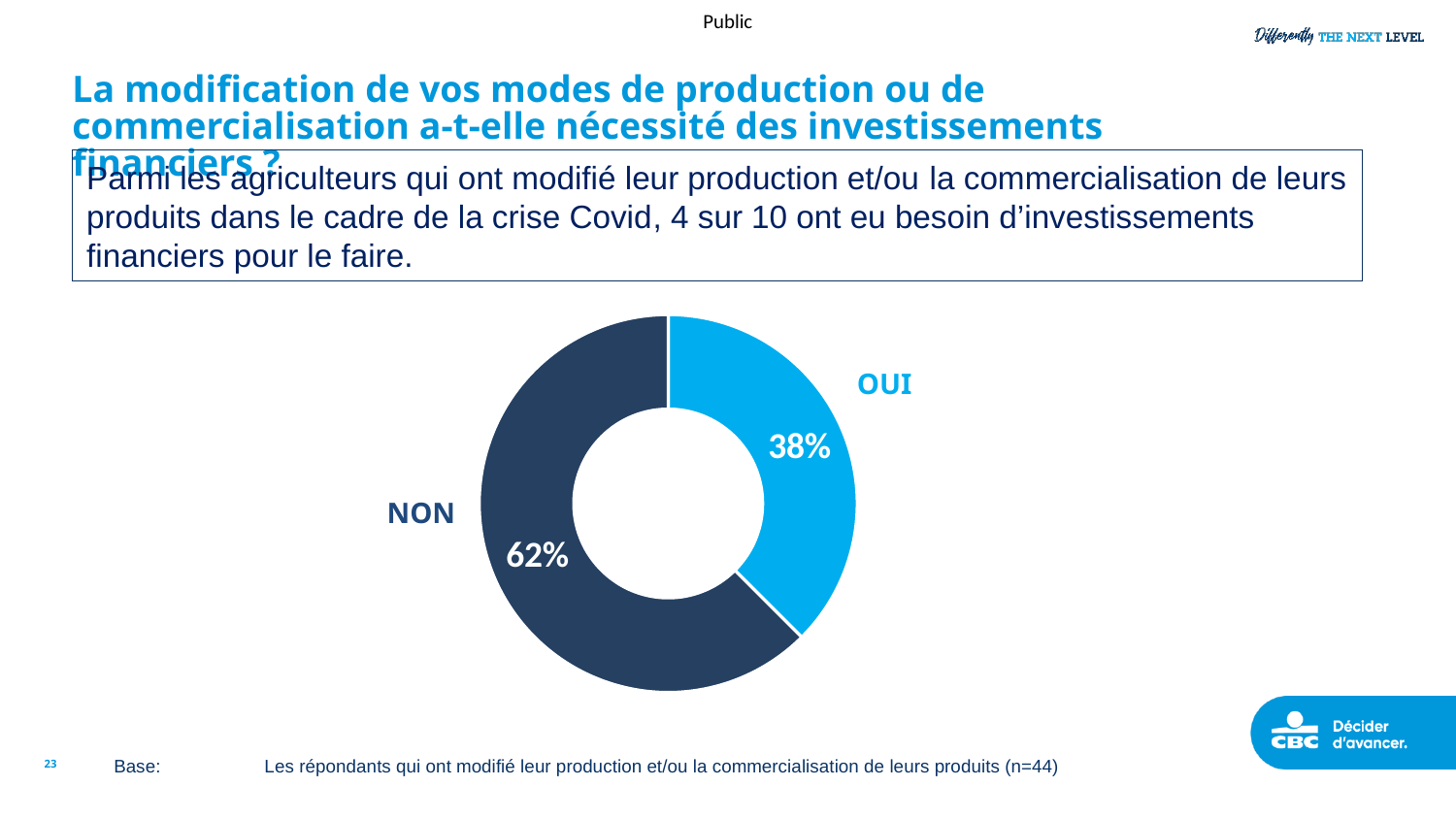
What colour is the OUI slice? Light blue Which category has the largest share of the pie? NON What share of the pie does the OUI slice represent? 38% Which is larger, the share for OUI or the share for NON? NON How many categories are shown in the chart? 2 What is the sample size (n) stated in the base note below the chart? n=44 What is the difference in percentage points between NON and OUI? 24 What percentage of respondents answered OUI? 38% What percentage of respondents answered NON? 62% Which category has the smallest share of the pie? OUI What kind of chart is shown on the slide? Pie chart (donut)